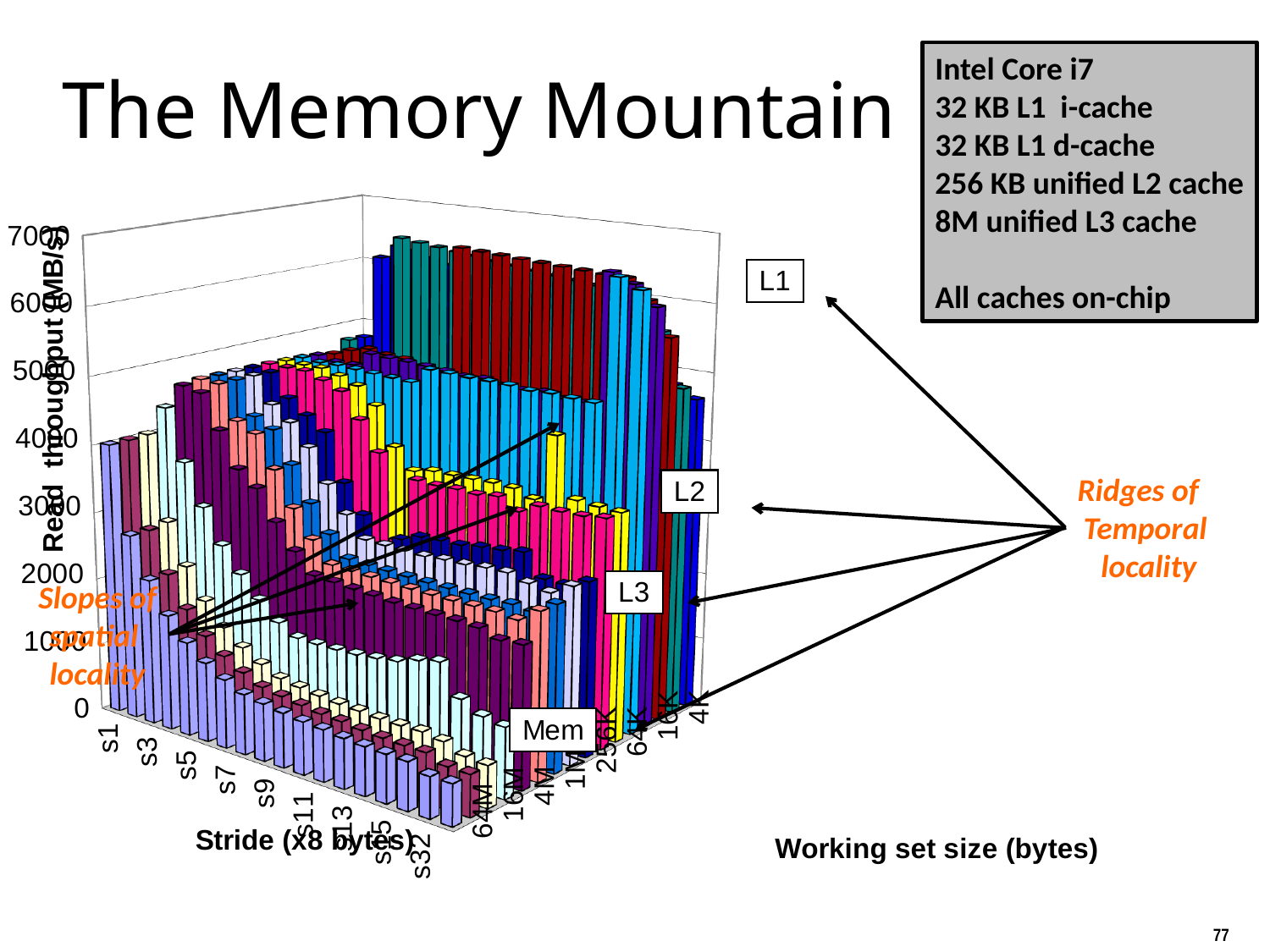
What is the label of the vertical axis of the chart? Read throughput (MB/s) Which of the labeled regions L1, L2, L3 or Mem has the highest read throughput? L1 What is the title of the slide containing the chart? The Memory Mountain Which of the labeled regions L1, L2, L3 or Mem has the lowest read throughput? Mem Is the read throughput for stride s32 at working set size 64M greater or less than 1000? less Is the highest read throughput shown on the chart greater or less than 5000? greater Is the read throughput in the L3 region at stride s1 greater or less than 6000? less Do read throughput values rise or fall as the stride increases from s1 to s32? fall For stride s1, which working set size gives higher read throughput, 4K or 64M? 4K What kind of chart is shown on the slide? bar chart